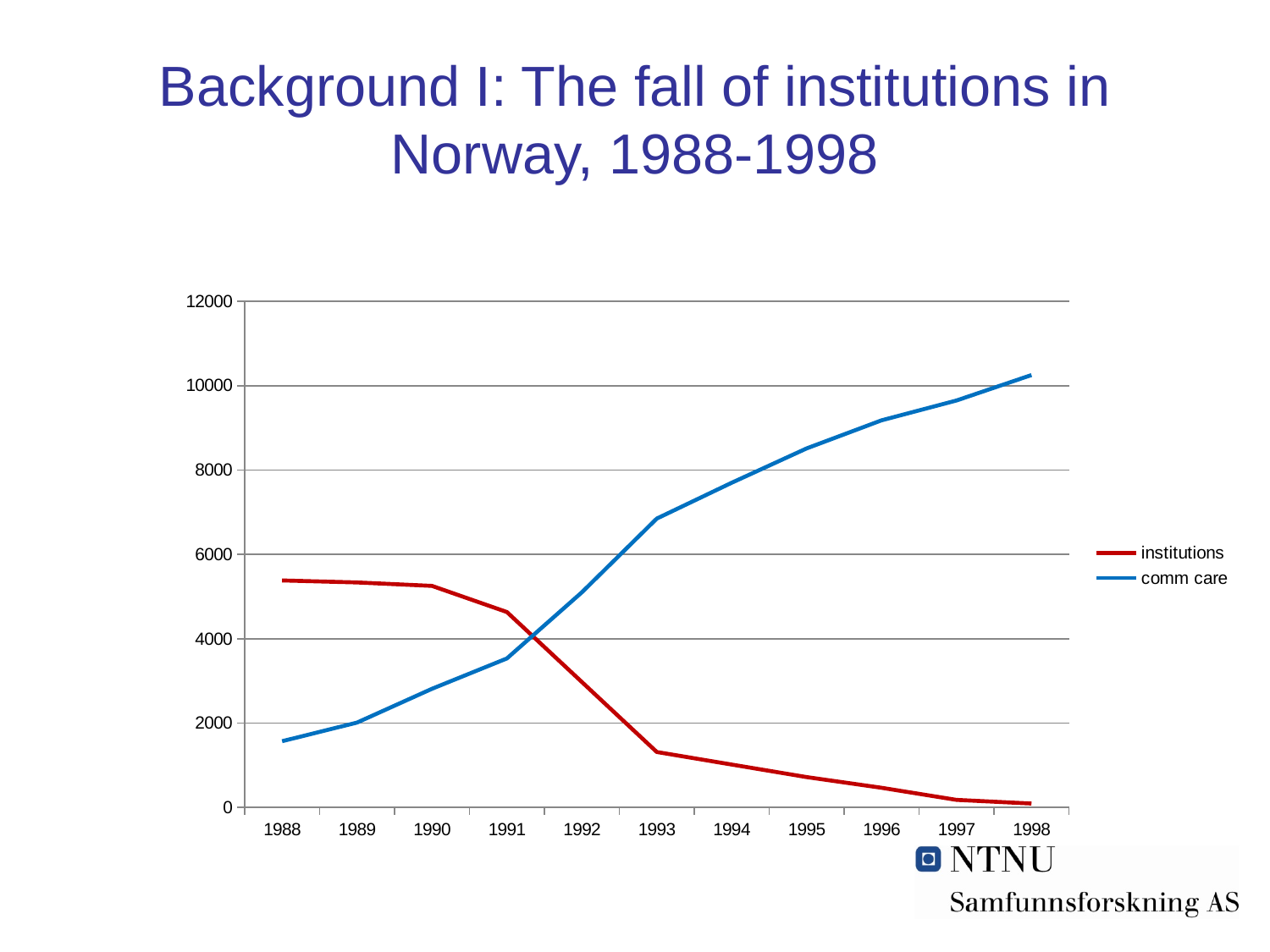
What kind of chart is shown on the slide? line chart Does the comm care series rise or fall from 1988 to 1998? rise In 1998, which series has the larger value, institutions or comm care? comm care Which series is drawn in red? institutions In 1988, which series has the larger value, institutions or comm care? institutions In which year is the institutions value lowest? 1998 Is the value for institutions in 1988 greater or less than 4000? greater How many years are plotted along the x axis? 11 In which year is the comm care value highest? 1998 Is the value for comm care in 1988 greater or less than 2000? less Does the institutions series rise or fall from 1988 to 1998? fall How many series does the legend list? 2